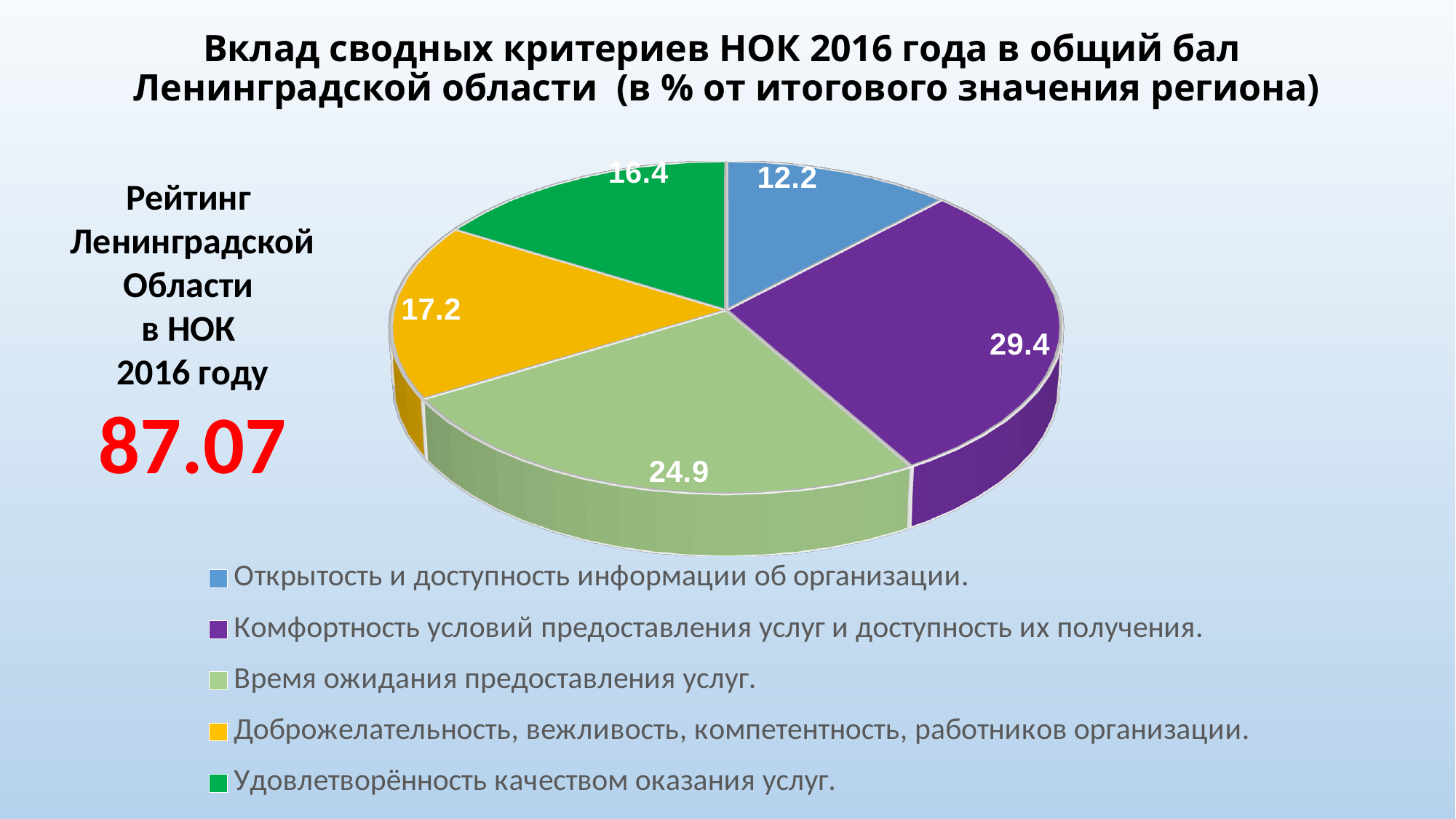
What colour is the slice for "Время ожидания предоставления услуг"? Light green How many entries does the legend list? 5 Which category has the smallest slice of the pie? Открытость и доступность информации об организации What is the value for "Открытость и доступность информации об организации"? 12.2 What is the value for "Комфортность условий предоставления услуг и доступность их получения"? 29.4 Which is larger: the value for "Доброжелательность, вежливость, компетентность, работников организации" or the value for "Удовлетворённость качеством оказания услуг"? Доброжелательность, вежливость, компетентность, работников организации What is the value for "Время ожидания предоставления услуг"? 24.9 Which category has the largest slice of the pie? Комфортность условий предоставления услуг и доступность их получения What is the value for "Удовлетворённость качеством оказания услуг"? 16.4 What is the difference between the values for "Комфортность условий предоставления услуг и доступность их получения" and "Время ожидания предоставления услуг"? 4.5 What type of chart is shown on the slide? Pie chart How many slices does the pie chart have? 5